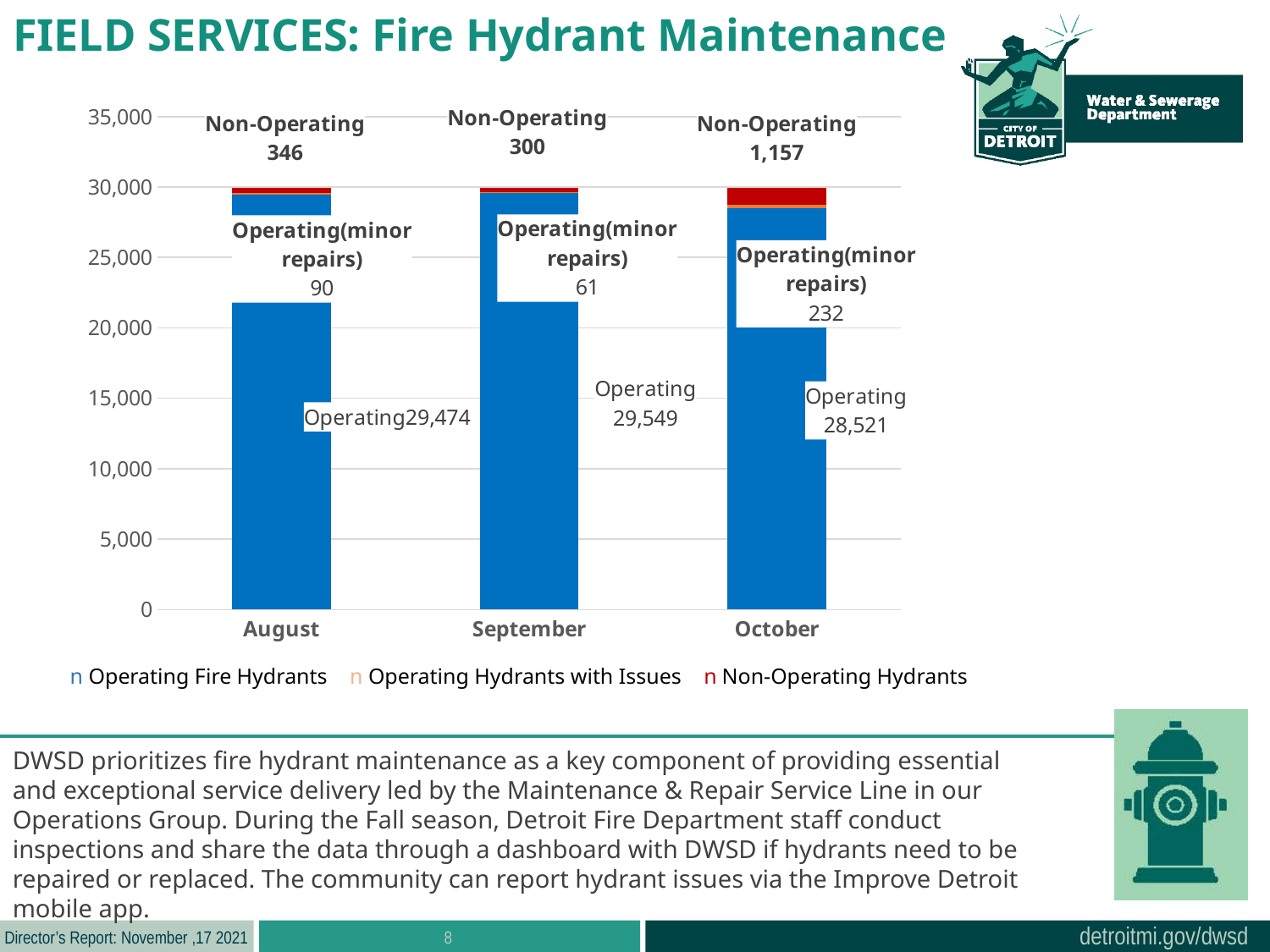
How many months are shown on the x axis of the chart? 3 Which month has the highest number of Non-Operating hydrants? October Which month has the lowest Operating (minor repairs) value? September Which series is shown in red in the chart legend? Non-Operating Hydrants What is the difference between the Operating hydrant counts in September and October? 1,028 What is the total of the stacked bar for October? 29,910 How many series does the chart legend list? 3 What is the Operating (minor repairs) value for August? 90 What is the Non-Operating hydrant count for October? 1,157 Which is larger: the Non-Operating count in August or in September? August What is the number of Operating fire hydrants in September? 29,549 What type of chart is shown on the slide? Stacked bar chart